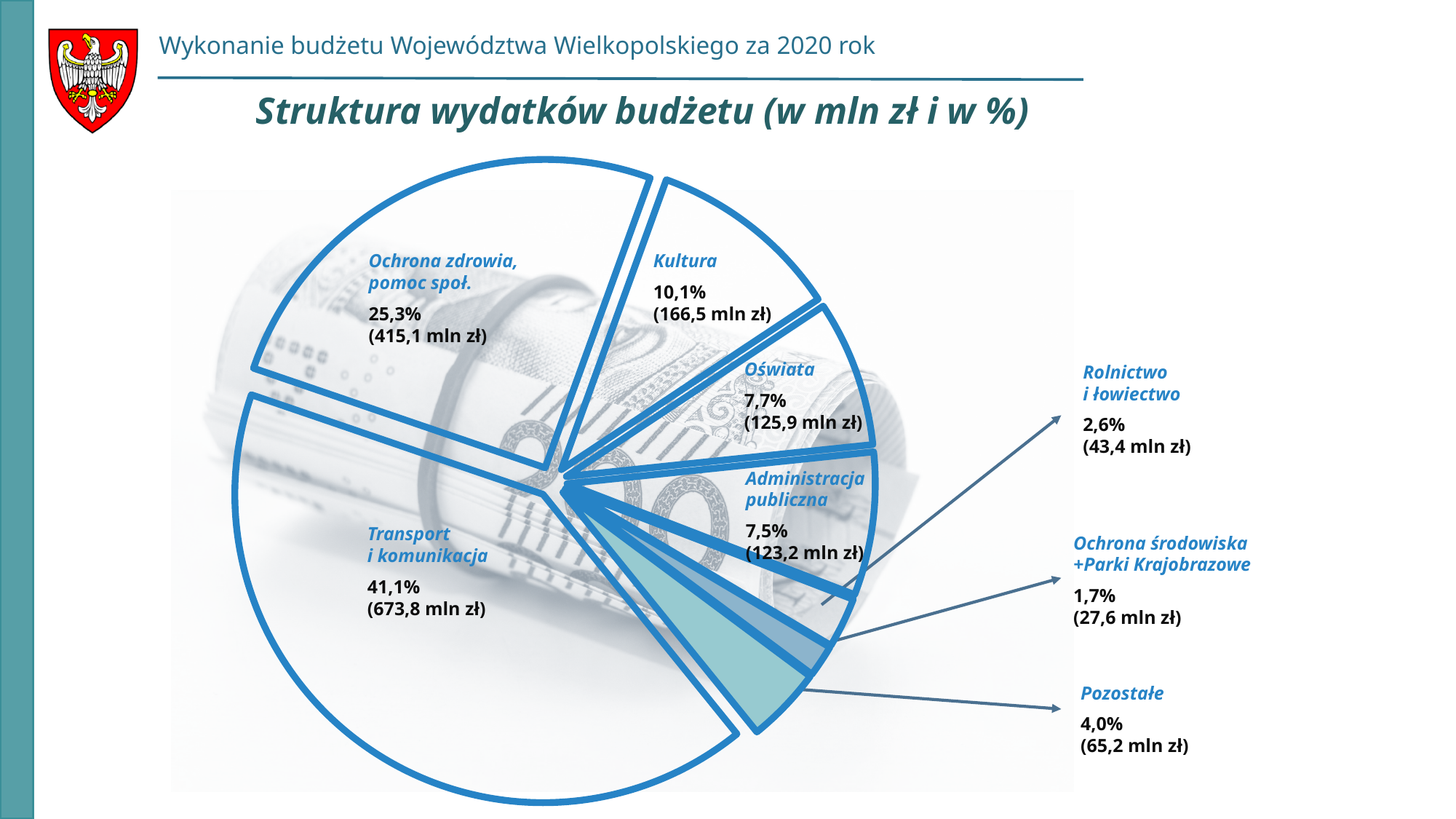
Which is larger: the value for Oświata or the value for Administracja publiczna? Oświata What kind of chart is shown on the slide? pie chart Which category has the smallest share of the budget expenditure? Ochrona środowiska +Parki Krajobrazowe What is the title of the chart? Struktura wydatków budżetu (w mln zł i w %) Which category has the largest share of the budget expenditure? Transport i komunikacja What is the value in mln zł for Kultura? 166,5 mln zł What percentage share does Oświata have? 7,7% What is the value in mln zł for Ochrona zdrowia, pomoc społ.? 415,1 mln zł How many slices does the pie chart have? 8 What is the difference in mln zł between Transport i komunikacja and Ochrona zdrowia, pomoc społ.? 258,7 mln zł What share of the budget expenditure goes to Transport i komunikacja? 41,1% What is the value in mln zł for Rolnictwo i łowiectwo? 43,4 mln zł